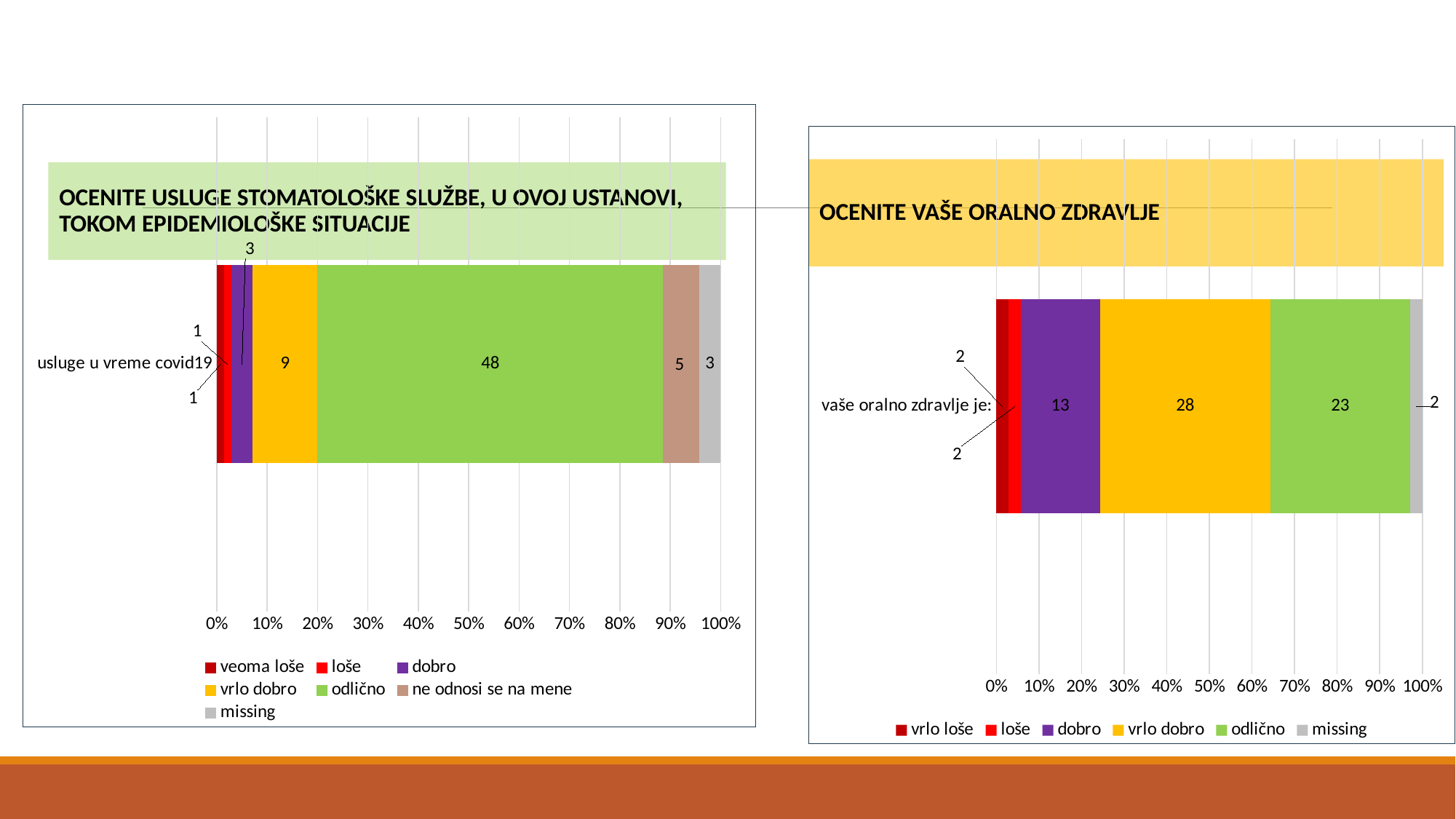
In the left chart (OCENITE USLUGE STOMATOLOŠKE SLUŽBE...), what is the value for 'ne odnosi se na mene'? 5 In the chart titled 'OCENITE VAŠE ORALNO ZDRAVLJE', which series has the highest value? vrlo dobro In the left chart (OCENITE USLUGE STOMATOLOŠKE SLUŽBE...), what is the value for 'odlično'? 48 In the chart titled 'OCENITE VAŠE ORALNO ZDRAVLJE', which is larger, the value for 'dobro' or the value for 'odlično'? odlično What kind of chart is the chart titled 'OCENITE VAŠE ORALNO ZDRAVLJE'? Stacked bar chart How many series does the legend of the left chart (OCENITE USLUGE STOMATOLOŠKE SLUŽBE...) list? 7 In the chart titled 'OCENITE VAŠE ORALNO ZDRAVLJE', what is the value for 'vrlo dobro'? 28 In the left chart (OCENITE USLUGE STOMATOLOŠKE SLUŽBE...), which series has the highest value? odlično In the left chart (OCENITE USLUGE STOMATOLOŠKE SLUŽBE...), what is the difference between the values for 'odlično' and 'vrlo dobro'? 39 In the chart titled 'OCENITE VAŠE ORALNO ZDRAVLJE', what is the value for 'dobro'? 13 How many series does the legend of the chart titled 'OCENITE VAŠE ORALNO ZDRAVLJE' list? 6 In the chart titled 'OCENITE VAŠE ORALNO ZDRAVLJE', what is the difference between the values for 'vrlo dobro' and 'odlično'? 5